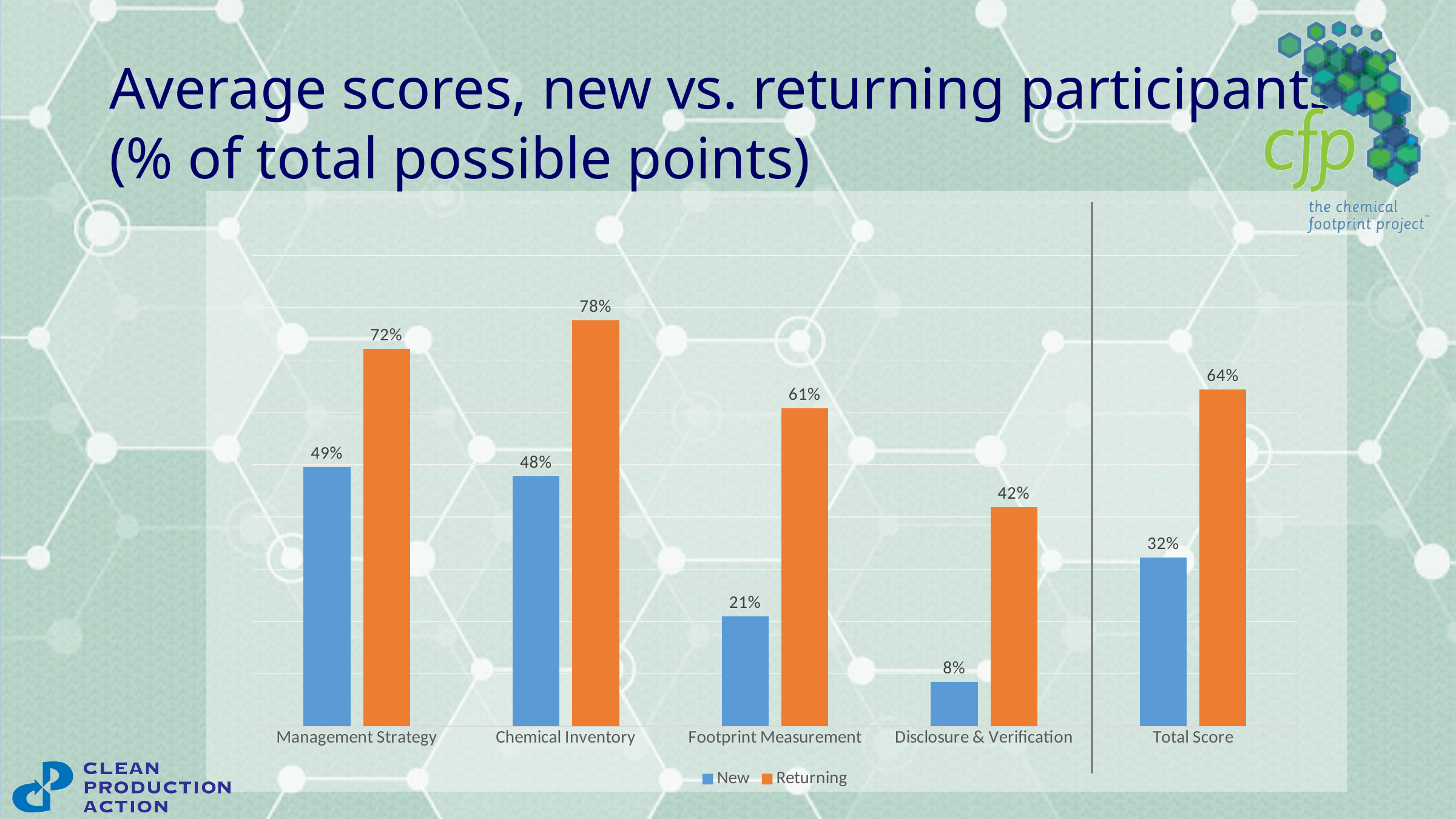
What is the value for Returning participants in Chemical Inventory? 78% Which is larger: the New value for Management Strategy or the New value for Chemical Inventory? Management Strategy What is the value for New participants in Disclosure & Verification? 8% What is the difference between Returning and New participants in Total Score? 32% What is the difference between Returning and New participants in Footprint Measurement? 40% What is the value for New participants in Management Strategy? 49% Which category has the lowest value for New participants? Disclosure & Verification Which category has the highest value for Returning participants? Chemical Inventory What is the Total Score for Returning participants? 64% How many categories are shown on the x axis? 5 How many series does the legend list? 2 What kind of chart is shown on the slide? Bar chart